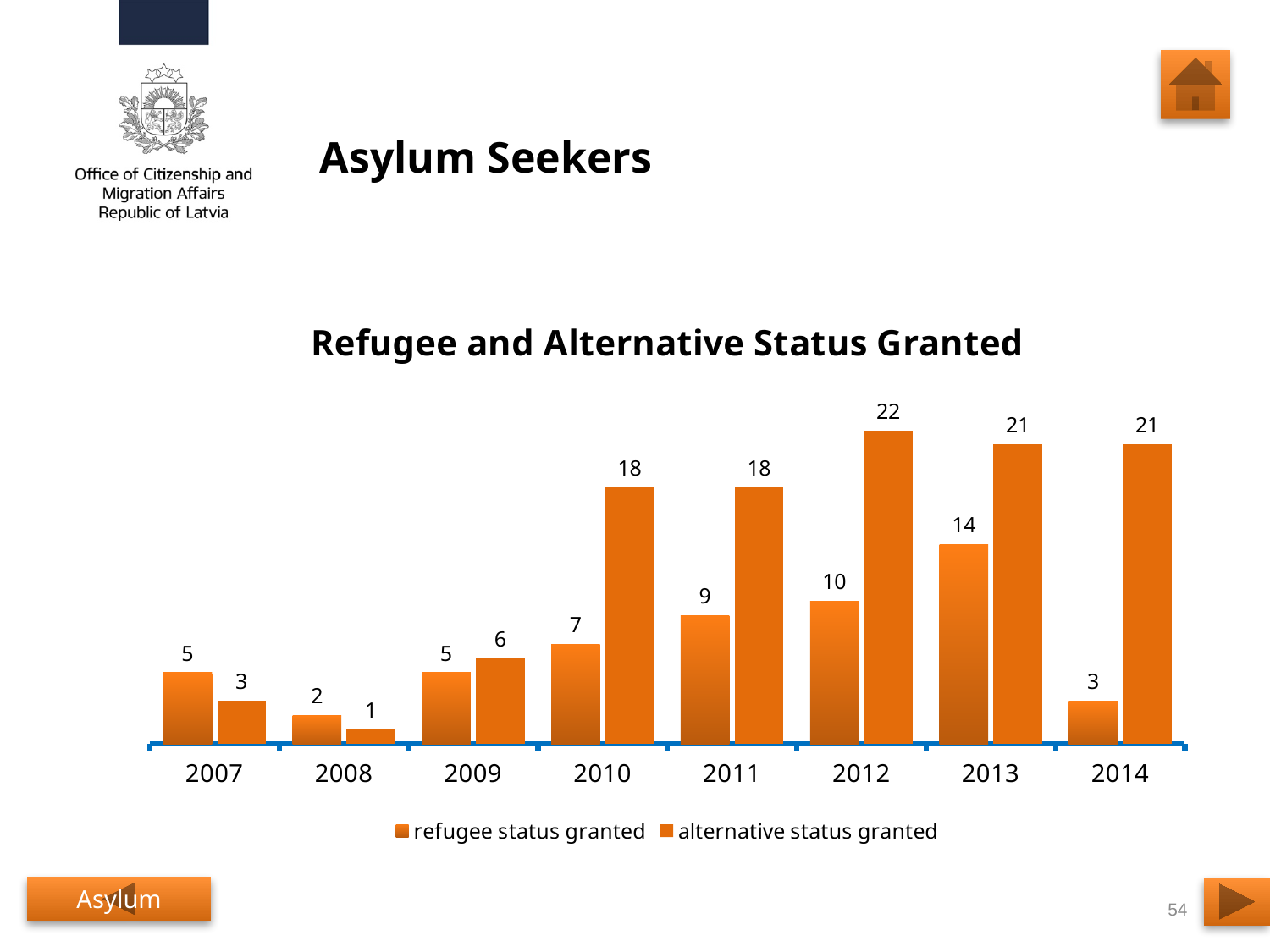
How many series does the legend list? 2 What is the value for refugee status granted in 2014? 3 In which year is refugee status granted lowest? 2008 What is the value for alternative status granted in 2010? 18 What is the title of the chart? Refugee and Alternative Status Granted What is the difference between alternative status granted and refugee status granted in 2013? 7 What kind of chart is shown on the slide? bar chart In which year is alternative status granted highest? 2012 How many years are shown on the x axis? 8 Which is larger in 2007: refugee status granted or alternative status granted? refugee status granted What is the total of refugee status granted and alternative status granted in 2011? 27 What is the value for refugee status granted in 2012? 10